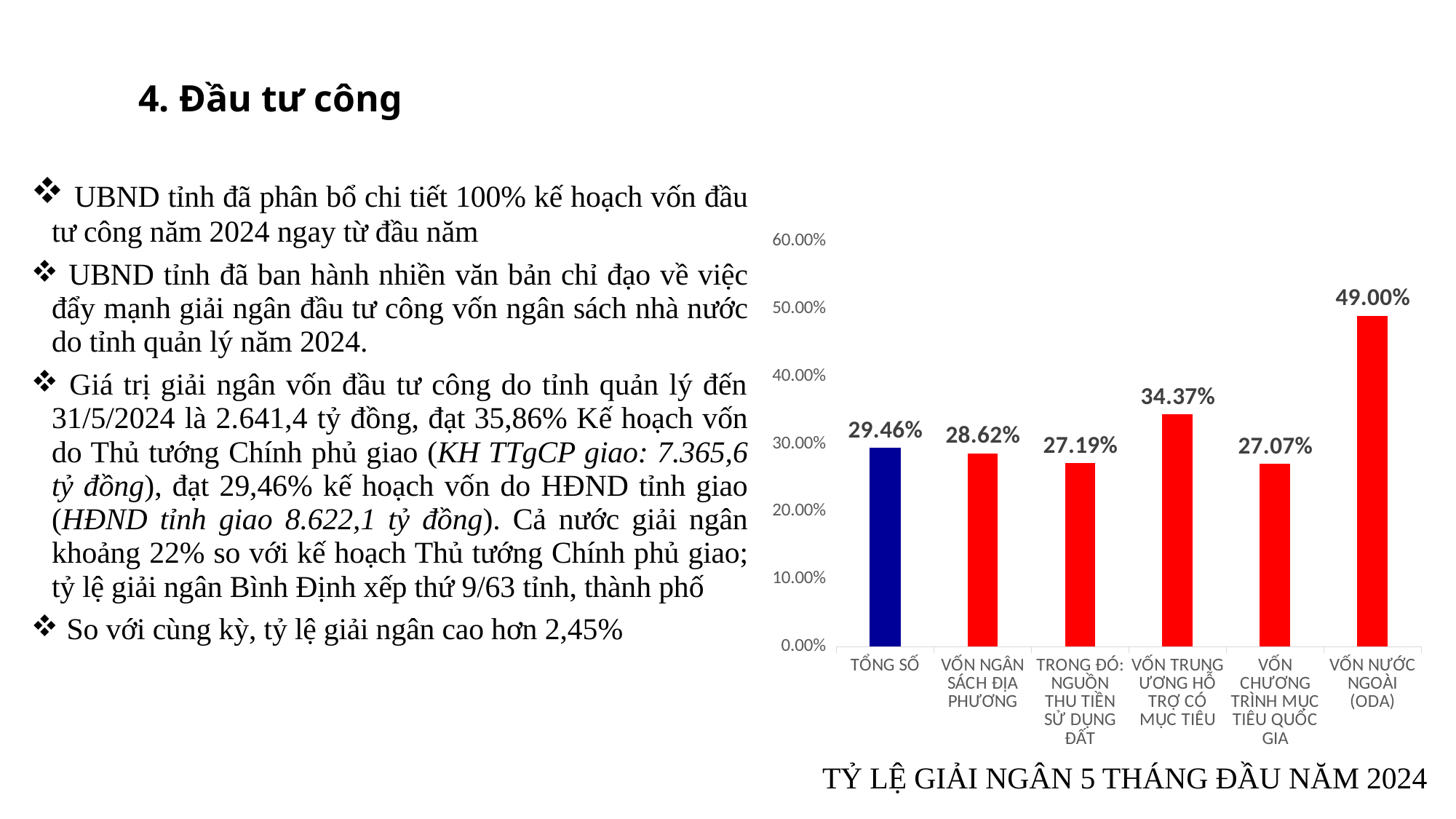
How many categories are shown in the chart? 6 Which is larger, the value for VỐN TRUNG ƯƠNG HỖ TRỢ CÓ MỤC TIÊU or the value for VỐN NGÂN SÁCH ĐỊA PHƯƠNG? VỐN TRUNG ƯƠNG HỖ TRỢ CÓ MỤC TIÊU What is the difference between the values for VỐN NƯỚC NGOÀI (ODA) and VỐN TRUNG ƯƠNG HỖ TRỢ CÓ MỤC TIÊU? 14.63% Which category has the lowest disbursement rate? VỐN CHƯƠNG TRÌNH MỤC TIÊU QUỐC GIA What is the disbursement rate for VỐN NƯỚC NGOÀI (ODA)? 49.00% What is the value for VỐN CHƯƠNG TRÌNH MỤC TIÊU QUỐC GIA? 27.07% Is the value for VỐN NƯỚC NGOÀI (ODA) greater or less than 40.00%? greater What is the difference between TỔNG SỐ and VỐN NGÂN SÁCH ĐỊA PHƯƠNG? 0.84% What type of chart is shown on the slide? Bar chart Which category has the highest disbursement rate? VỐN NƯỚC NGOÀI (ODA) What is the value for VỐN TRUNG ƯƠNG HỖ TRỢ CÓ MỤC TIÊU? 34.37% What is the value shown for TỔNG SỐ? 29.46%